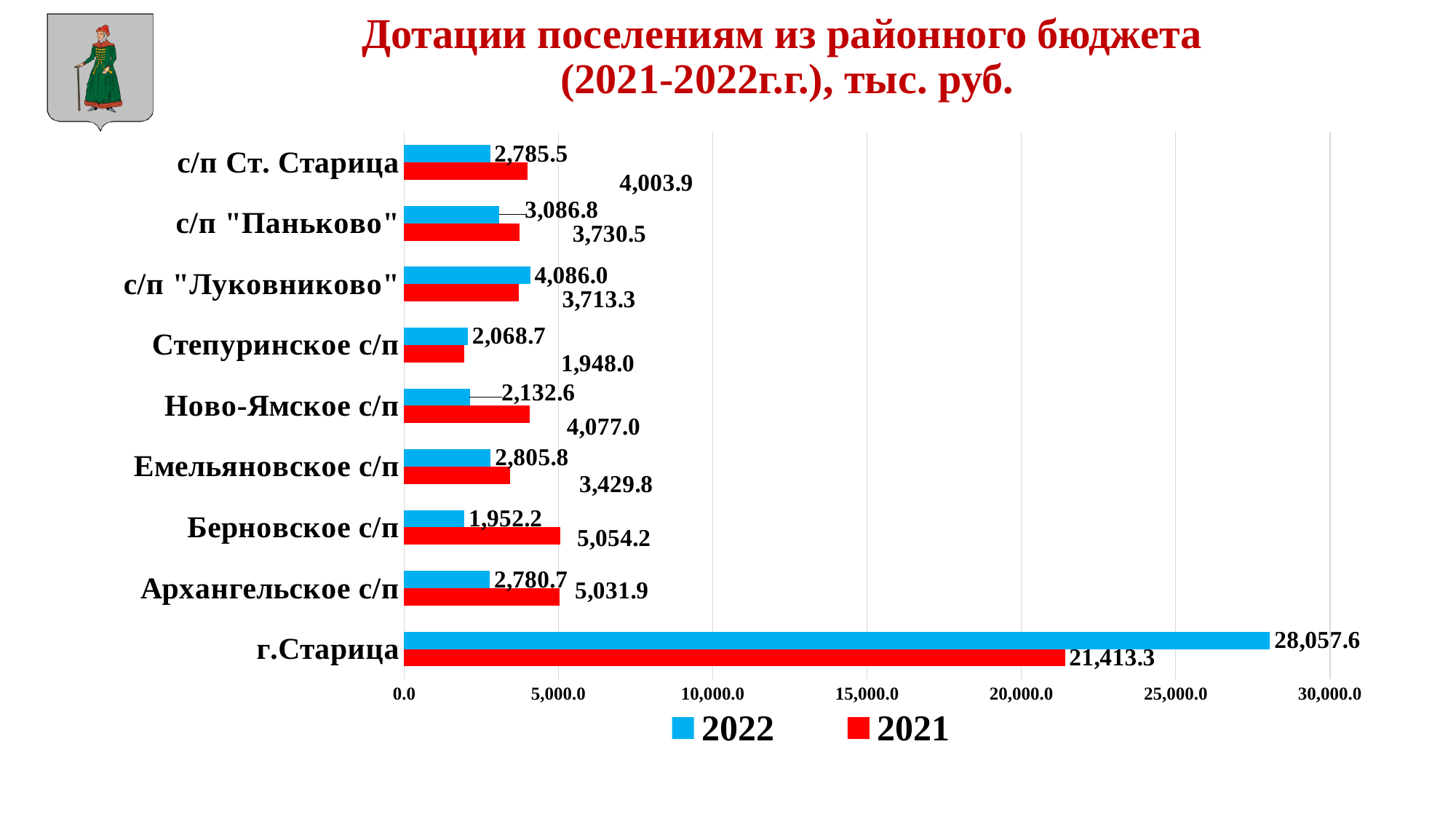
What is the 2021 value for Берновское с/п? 5,054.2 Which is larger for Ново-Ямское с/п, the 2022 value or the 2021 value? 2021 Which settlement has the lowest 2021 value? Степуринское с/п How many settlements (categories) are shown on the chart? 9 How many series does the legend list? 2 Which settlement has the highest 2021 value? г.Старица What is the difference between the 2022 and 2021 values for г.Старица? 6,644.3 What is the 2022 value for с/п "Луковниково"? 4,086.0 Is the 2021 value for г.Старица greater or less than 20,000.0? greater What is the 2022 value for г.Старица? 28,057.6 What kind of chart is shown on the slide? bar chart Which colour represents the 2022 series in the legend? blue